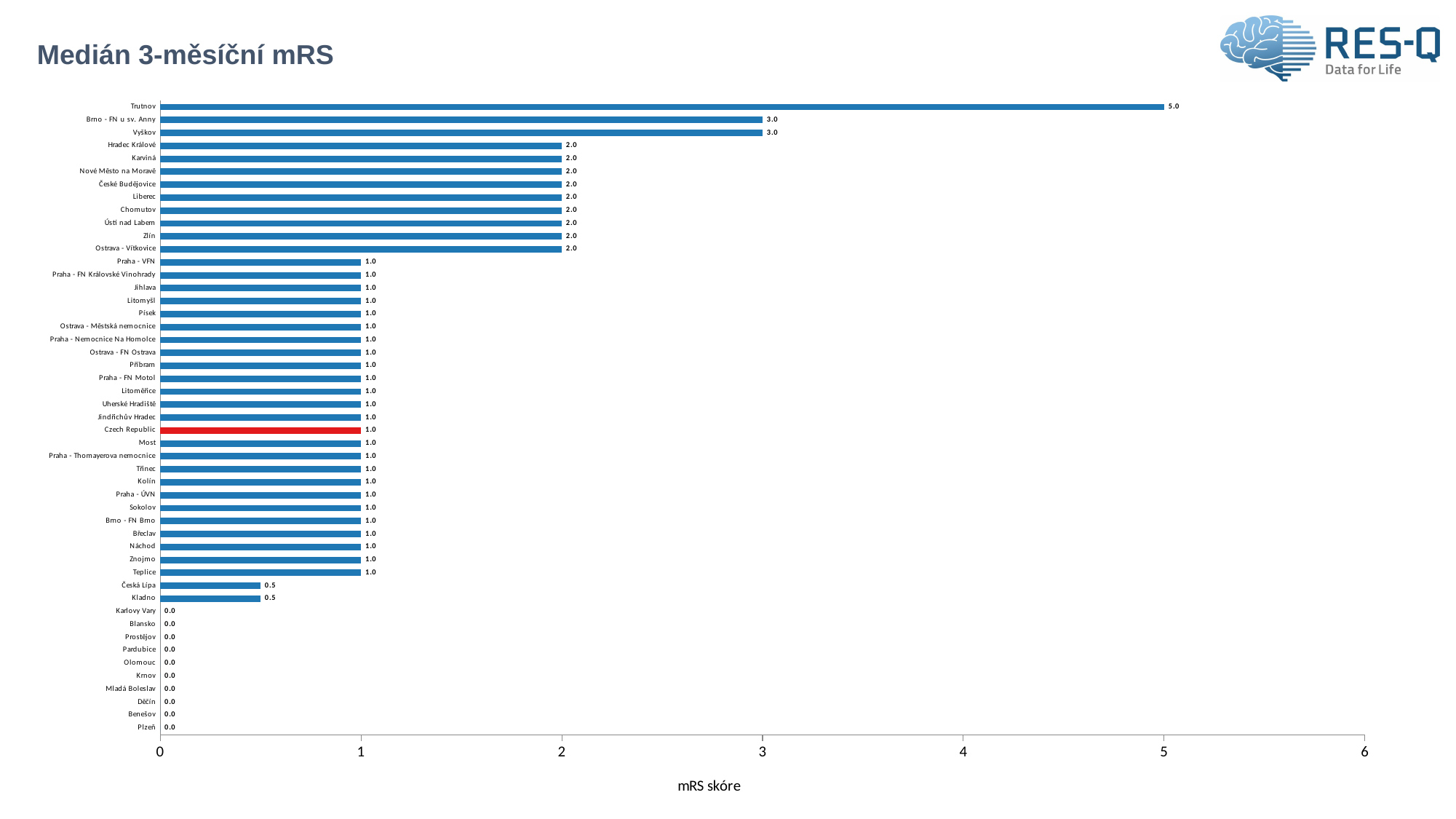
Which is larger, the value for Hradec Králové or the value for Praha - VFN? Hradec Králové Which bar is coloured red instead of blue? Czech Republic What kind of chart is shown on the slide? bar chart What is the value shown for Czech Republic? 1.0 What is the title of the chart? Medián 3-měsíční mRS What is the median 3-month mRS value for Trutnov? 5.0 What is the difference between the values for Trutnov and Brno - FN u sv. Anny? 2.0 How many categories have a value of 2.0? 9 What is the value shown for Vyškov? 3.0 What is the value shown for Kladno? 0.5 Which category has the highest value on the chart? Trutnov Is the value for Trutnov greater or less than 4? greater